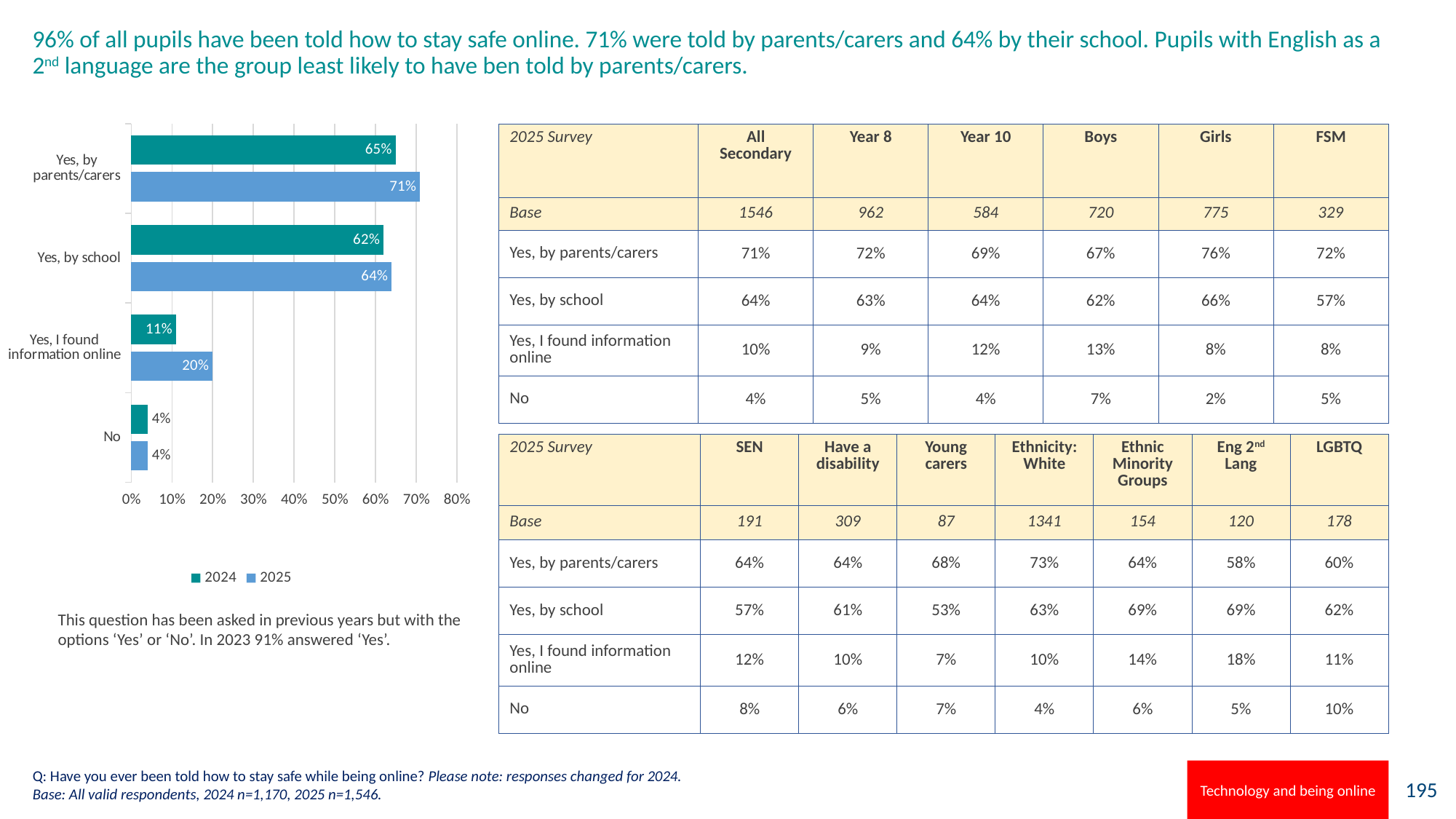
What is the maximum value shown on the x axis? 80% What is the difference between the 2025 and 2024 values for 'Yes, by parents/carers'? 6% How many categories are shown on the chart? 4 What is the difference between the 2025 and 2024 values for 'Yes, I found information online'? 9% How many series does the legend list? 2 What kind of chart is shown on the slide? bar chart Which is larger: the 2024 value for 'Yes, by school' or the 2025 value for 'Yes, by school'? 2025 What is the 2025 value for 'Yes, by parents/carers'? 71% What is the 2024 value for 'Yes, by school'? 62% Which category has the lowest 2024 value? No Which category has the highest 2025 value? Yes, by parents/carers What is the 2025 value for 'Yes, I found information online'? 20%